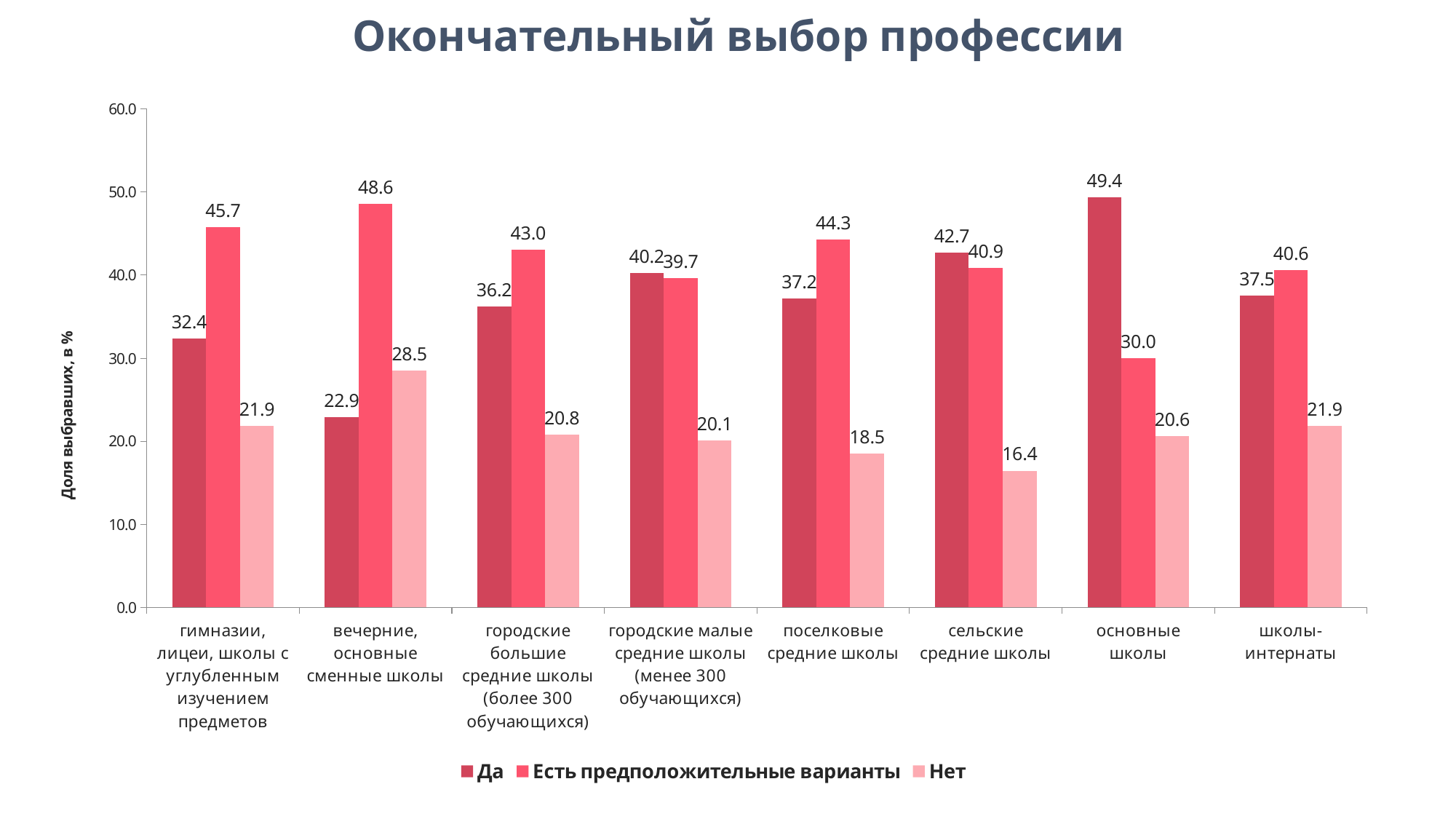
How many series does the legend list? 3 What is the value of the "Нет" series for "вечерние, основные сменные школы"? 28.5 What is the value of the "Есть предположительные варианты" series for "поселковые средние школы"? 44.3 How many school categories are shown on the x axis? 8 What type of chart is shown on the slide? bar chart Which category has the highest value in the "Да" series? основные школы What is the title of the chart? Окончательный выбор профессии Which category has the highest value in the "Есть предположительные варианты" series? вечерние, основные сменные школы Which category has the lowest value in the "Нет" series? сельские средние школы What is the value of the "Да" series for "основные школы"? 49.4 For "сельские средние школы", which is larger: the "Да" value or the "Есть предположительные варианты" value? Да What is the difference between the "Да" and "Нет" values for "основные школы"? 28.8